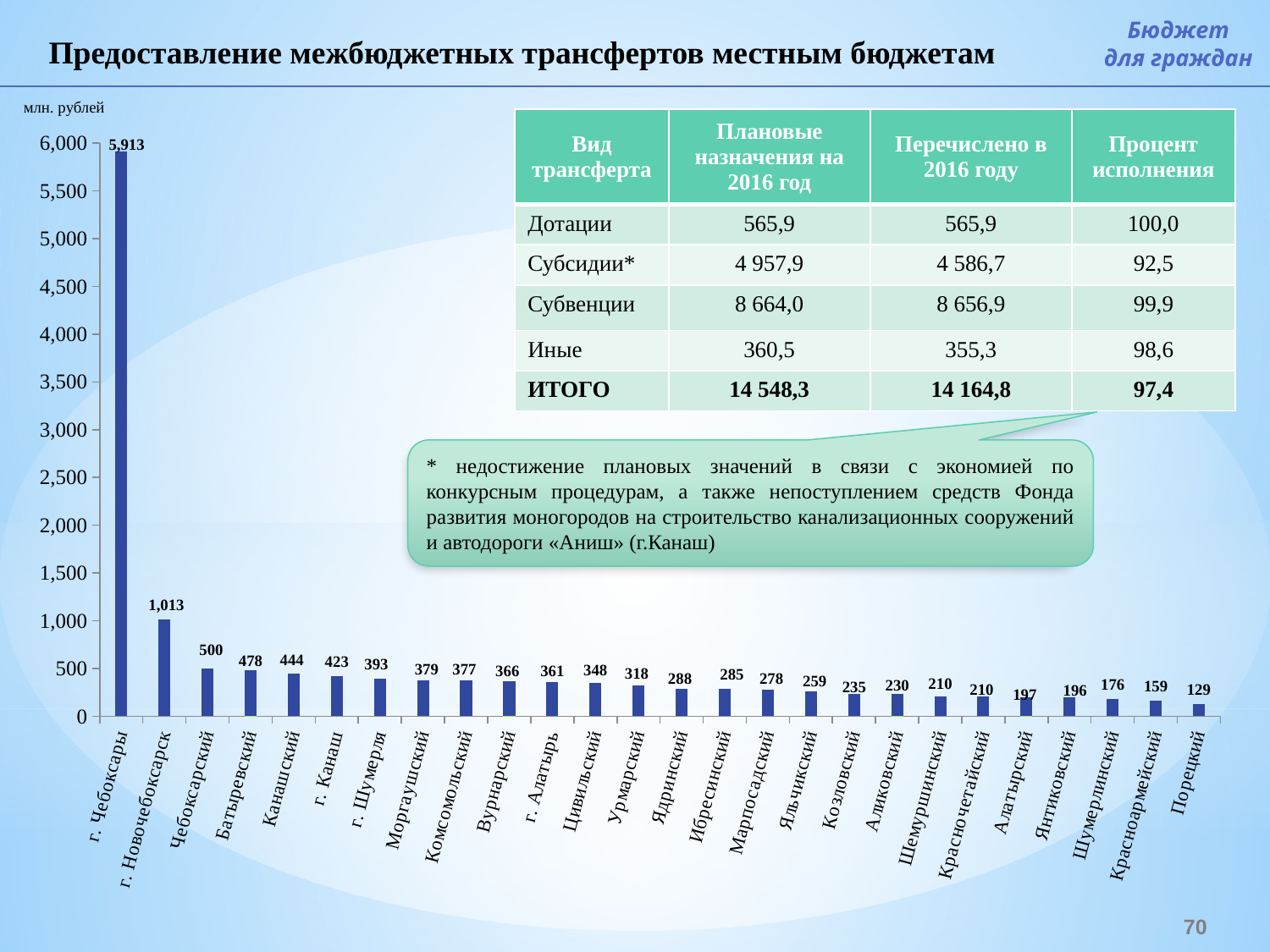
What is the value for Канашский? 444 Which category has the lowest value? Порецкий What is the value for г. Новочебоксарск? 1,013 What is the value for Порецкий? 129 How many categories are shown on the x axis? 26 What unit is indicated above the chart's vertical axis? млн. рублей Which is larger, the value for Цивильский or the value for Ядринский? Цивильский Which category has the highest value? г. Чебоксары What type of chart is shown on the slide? bar chart What is the value for г. Чебоксары? 5,913 What is the difference between the values for г. Чебоксары and г. Новочебоксарск? 4,900 Do the values generally rise or fall from left to right along the x axis? fall